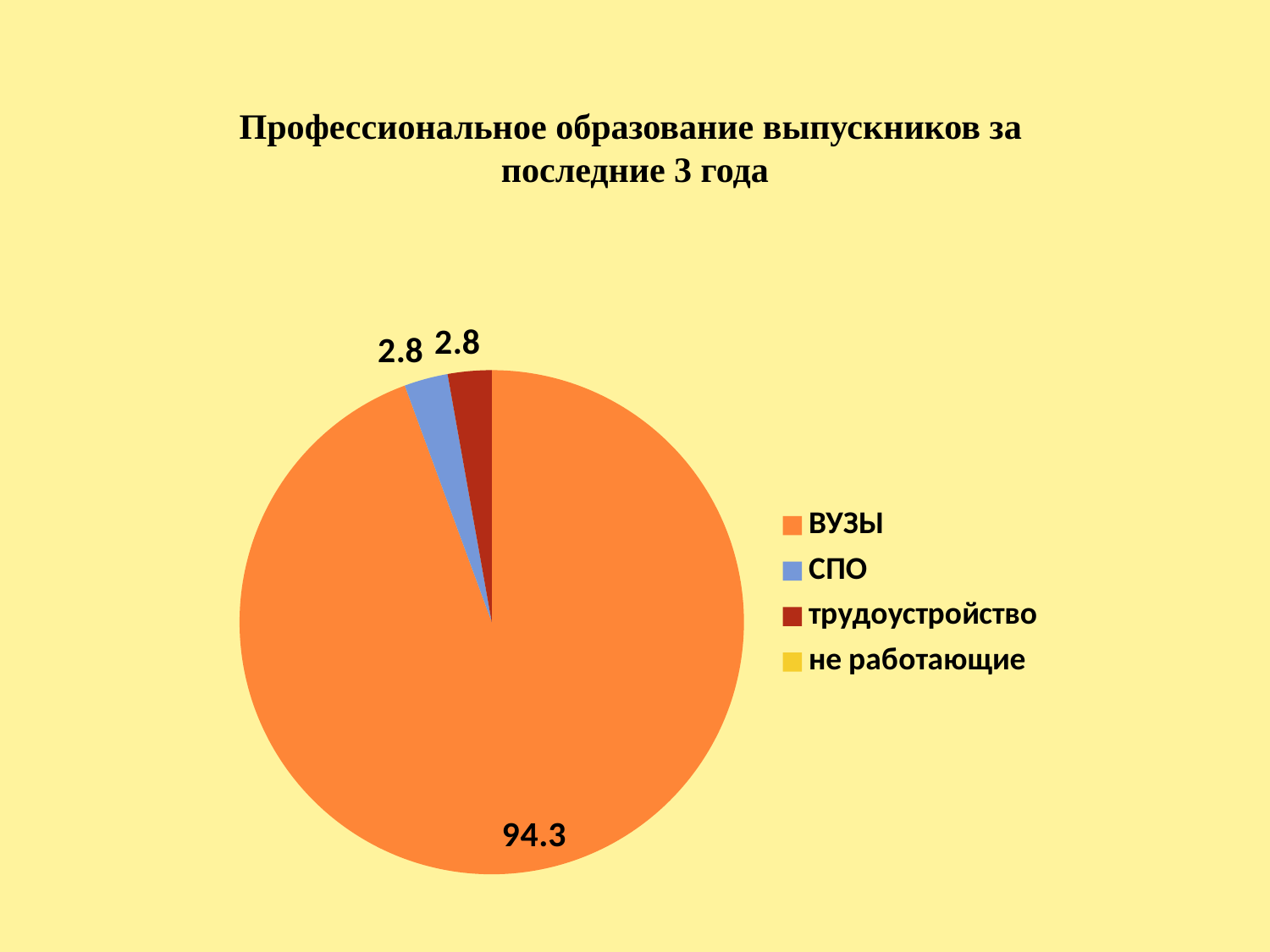
What colour is the ВУЗЫ slice in the pie chart? orange How many entries does the legend of the pie chart list? 4 What is the difference between the values for ВУЗЫ and СПО? 91.5 What is the value shown for СПО on the pie chart? 2.8 Which category has the largest slice of the pie chart? ВУЗЫ What is the value shown for трудоустройство on the pie chart? 2.8 How many slices with data labels are visible on the pie chart? 3 What is the value shown for ВУЗЫ on the pie chart? 94.3 What kind of chart is shown on the slide? pie chart What is the title of the chart on the slide? Профессиональное образование выпускников за последние 3 года Which is larger, the value for ВУЗЫ or the value for трудоустройство? ВУЗЫ